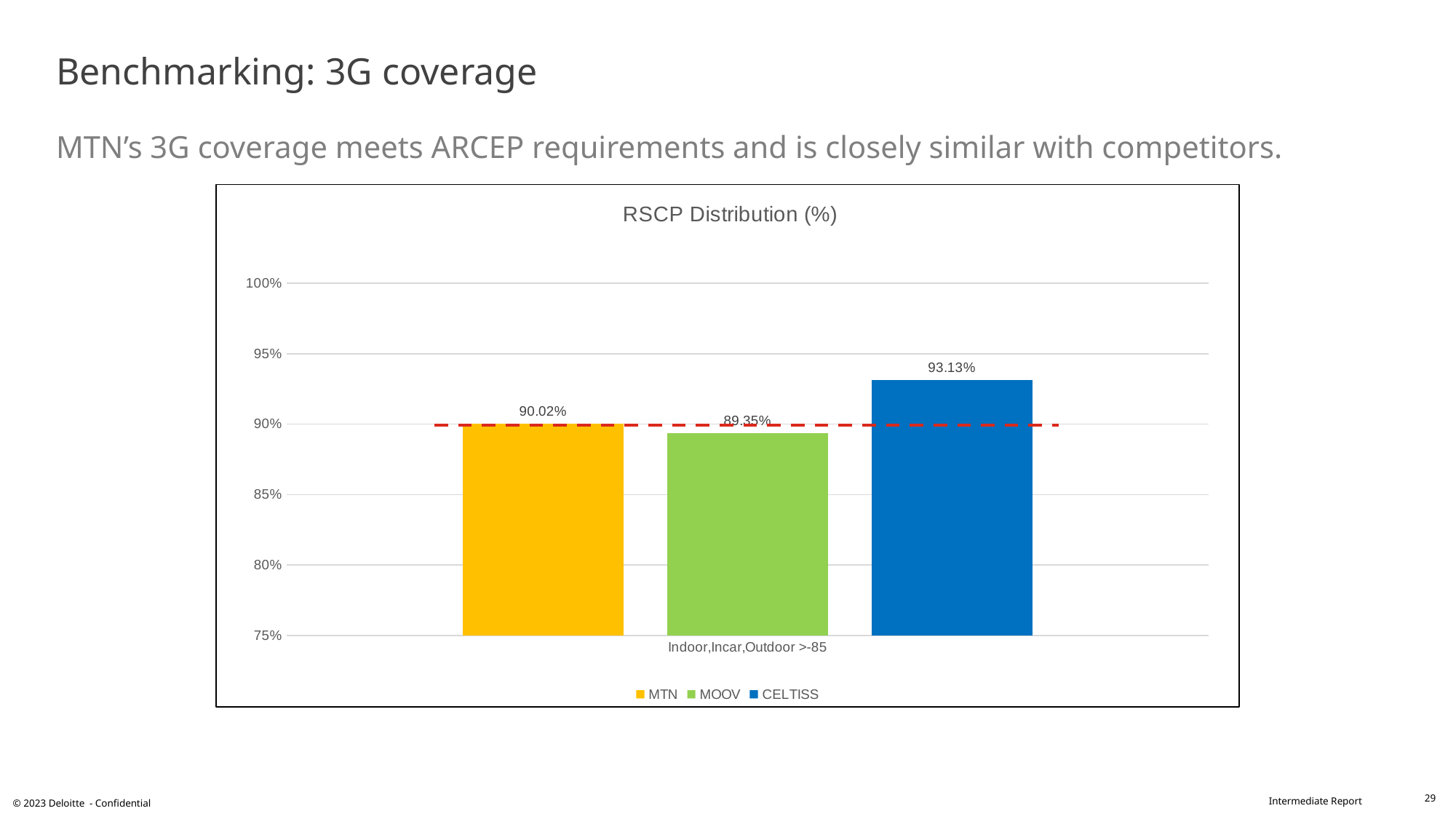
How many series does the legend of the RSCP Distribution (%) chart list? 3 What is the value for MOOV in the RSCP Distribution (%) chart? 89.35% Which operator has the lowest value in the RSCP Distribution (%) chart? MOOV What is the value for MTN in the RSCP Distribution (%) chart? 90.02% What kind of chart is the RSCP Distribution (%) chart? bar chart Which is larger in the RSCP Distribution (%) chart, the value for CELTISS or the value for MOOV? CELTISS Is the value for MOOV in the RSCP Distribution (%) chart greater or less than 90%? less What is the difference between the MTN and MOOV values in the RSCP Distribution (%) chart? 0.67% What is the value for CELTISS in the RSCP Distribution (%) chart? 93.13% What is the category label on the x axis of the RSCP Distribution (%) chart? Indoor,Incar,Outdoor >-85 Which operator has the highest value in the RSCP Distribution (%) chart? CELTISS What is the difference between the CELTISS and MTN values in the RSCP Distribution (%) chart? 3.11%